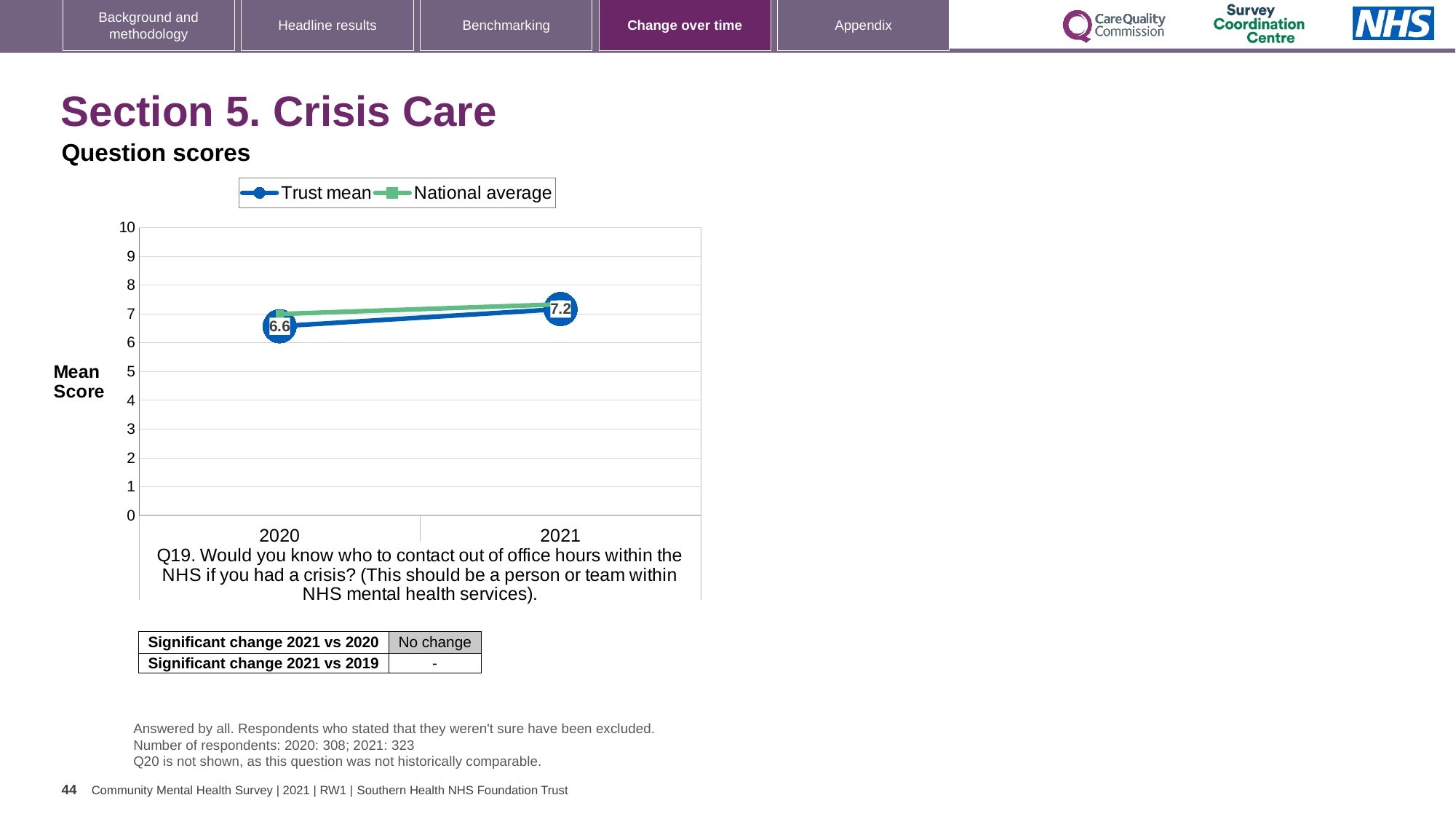
Which year has the higher Trust mean score, 2020 or 2021? 2021 What is the Trust mean score for 2021? 7.2 What is the Trust mean score for 2020? 6.6 How many years are plotted on the x axis? 2 Is the National average value for 2020 greater or less than 5? greater How many series does the legend list? 2 Is the National average value for 2021 greater or less than 8? less By how much did the Trust mean score change from 2020 to 2021? 0.6 What kind of chart is shown on the slide? line chart In 2020, which is higher, the Trust mean or the National average? National average Does the Trust mean line rise or fall from 2020 to 2021? rise What is the label on the y axis of the chart? Mean Score